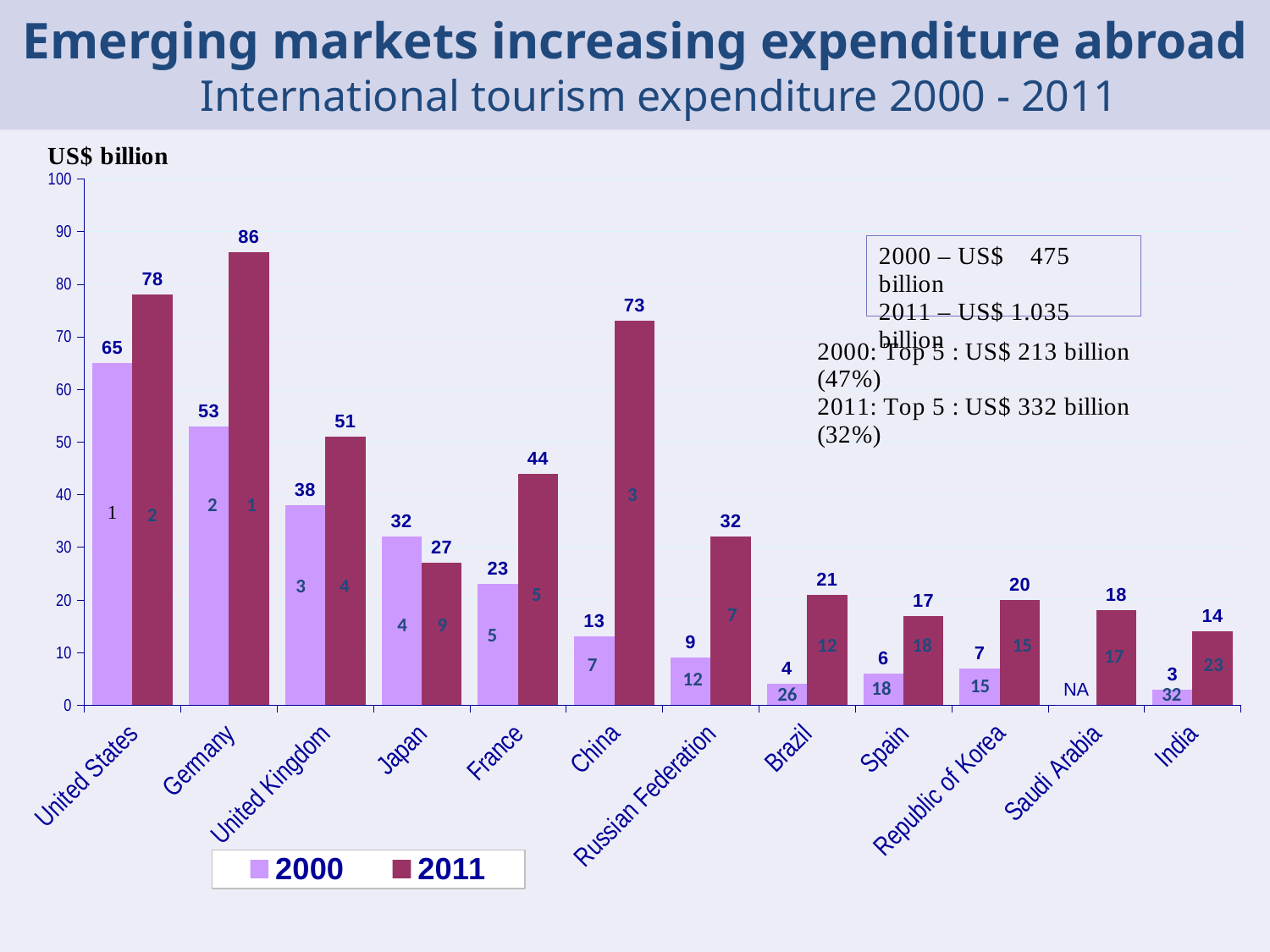
What is the difference between the United Kingdom's expenditure in 2011 and 2000? 13 What kind of chart is shown on the slide? Bar chart Which was larger, Japan's expenditure in 2000 or in 2011? 2000 Is the value for the United States in 2011 greater or less than 70? greater What was the international tourism expenditure of Germany in 2011? 86 What unit is shown above the y axis of the chart? US$ billion How many countries are shown on the x axis? 12 How many series does the legend list? 2 Which country had the lowest expenditure in 2000 among those with a value shown? India What was the international tourism expenditure of China in 2000? 13 By how much did China's expenditure increase from 2000 to 2011? 60 Which country had the highest expenditure in 2011? Germany